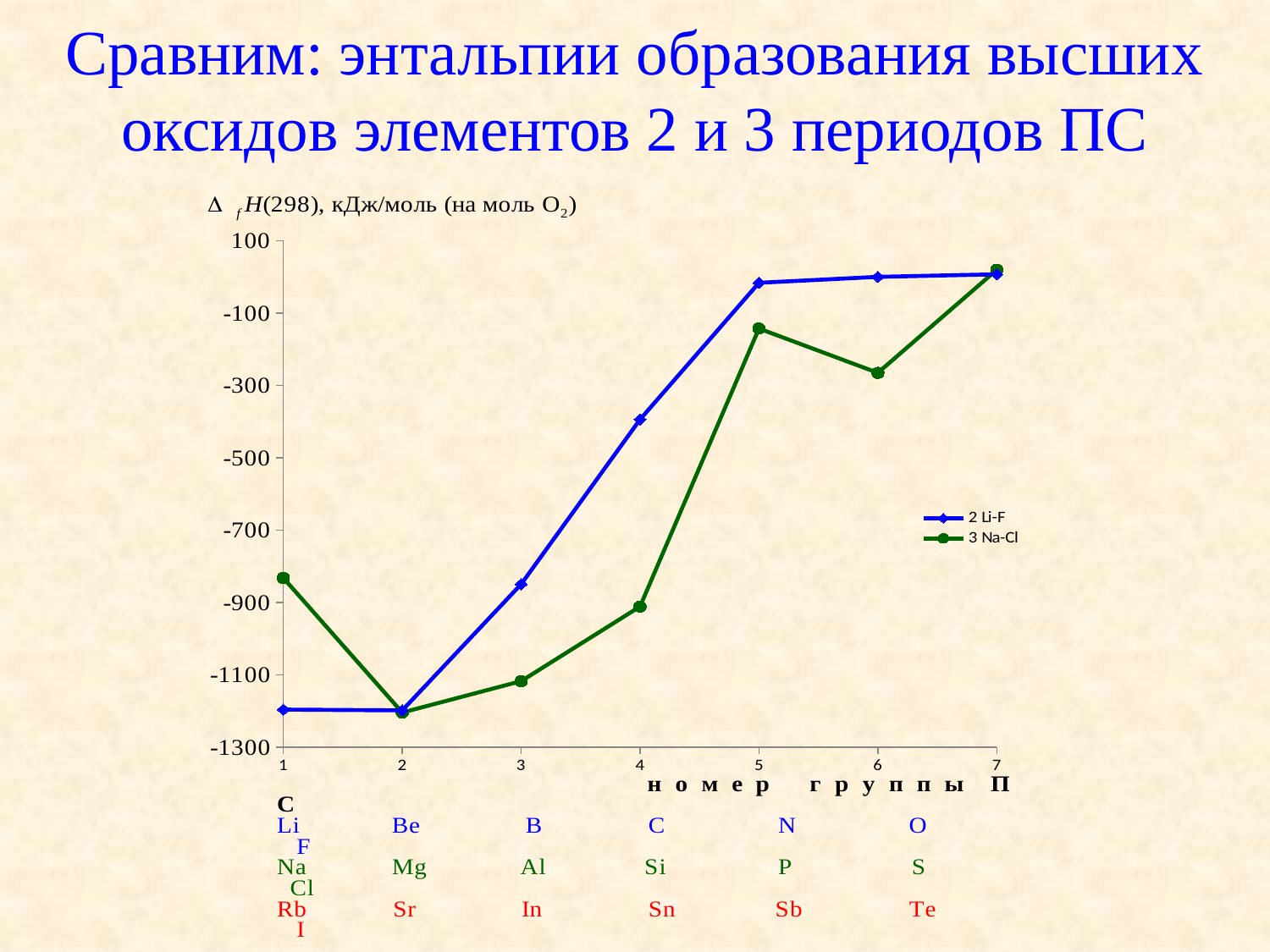
How many series does the legend list? 2 At group 1, which series has the higher value, 2 Li-F or 3 Na-Cl? 3 Na-Cl What are the two series names in the legend? 2 Li-F and 3 Na-Cl At which group number does the 3 Na-Cl series reach its lowest value? 2 At group 5, which series has the higher value, 2 Li-F or 3 Na-Cl? 2 Li-F What kind of chart is shown on the slide? line chart Is the value of the 3 Na-Cl series at group 6 greater or less than -100? less Is the value of the 2 Li-F series at group 4 greater or less than -500? greater Does the 3 Na-Cl series rise or fall from group 5 to group 6? fall Is the value of the 2 Li-F series at group 3 greater or less than -900? greater How many group numbers are marked along the x axis? 7